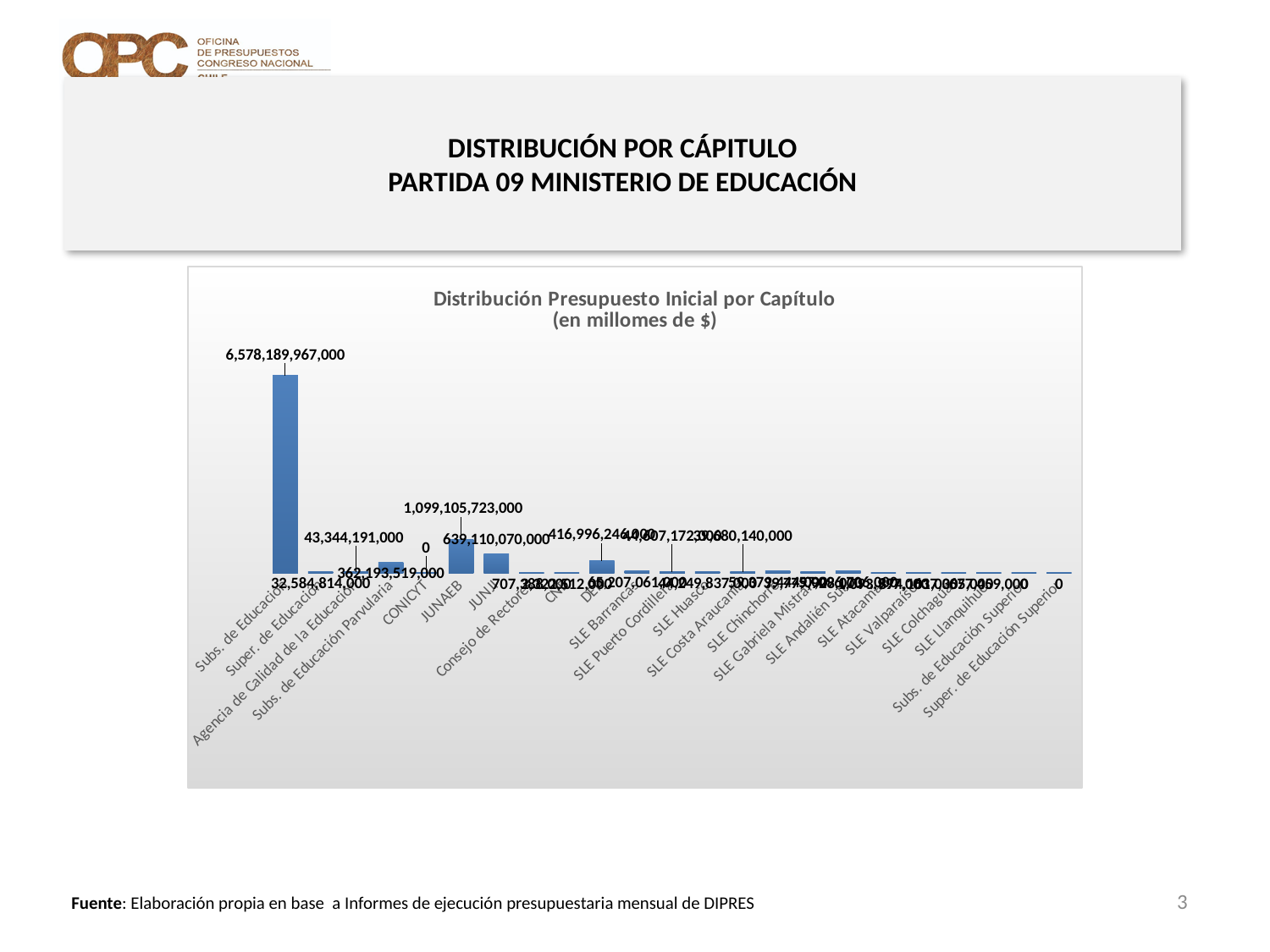
What type of chart is shown on the slide? bar chart What is the value shown for Subs. de Educación? 6,578,189,967,000 What is the difference between the values for Subs. de Educación and JUNAEB? 5,479,084,244,000 What is the value shown for Super. de Educación? 32,584,814,000 What is the value shown for Subs. de Educación Parvularia? 362,193,519,000 What is the difference between the values for Agencia de Calidad de la Educación and Super. de Educación? 10,759,377,000 Which is larger, the value for JUNAEB or the value for JUNJI? JUNAEB Which category has the highest value in the chart? Subs. de Educación What is the value shown for Agencia de Calidad de la Educación? 43,344,191,000 What is the value shown for CONICYT? 0 What is the value shown for JUNAEB? 1,099,105,723,000 What is the title of the chart? Distribución Presupuesto Inicial por Capítulo (en millomes de $)